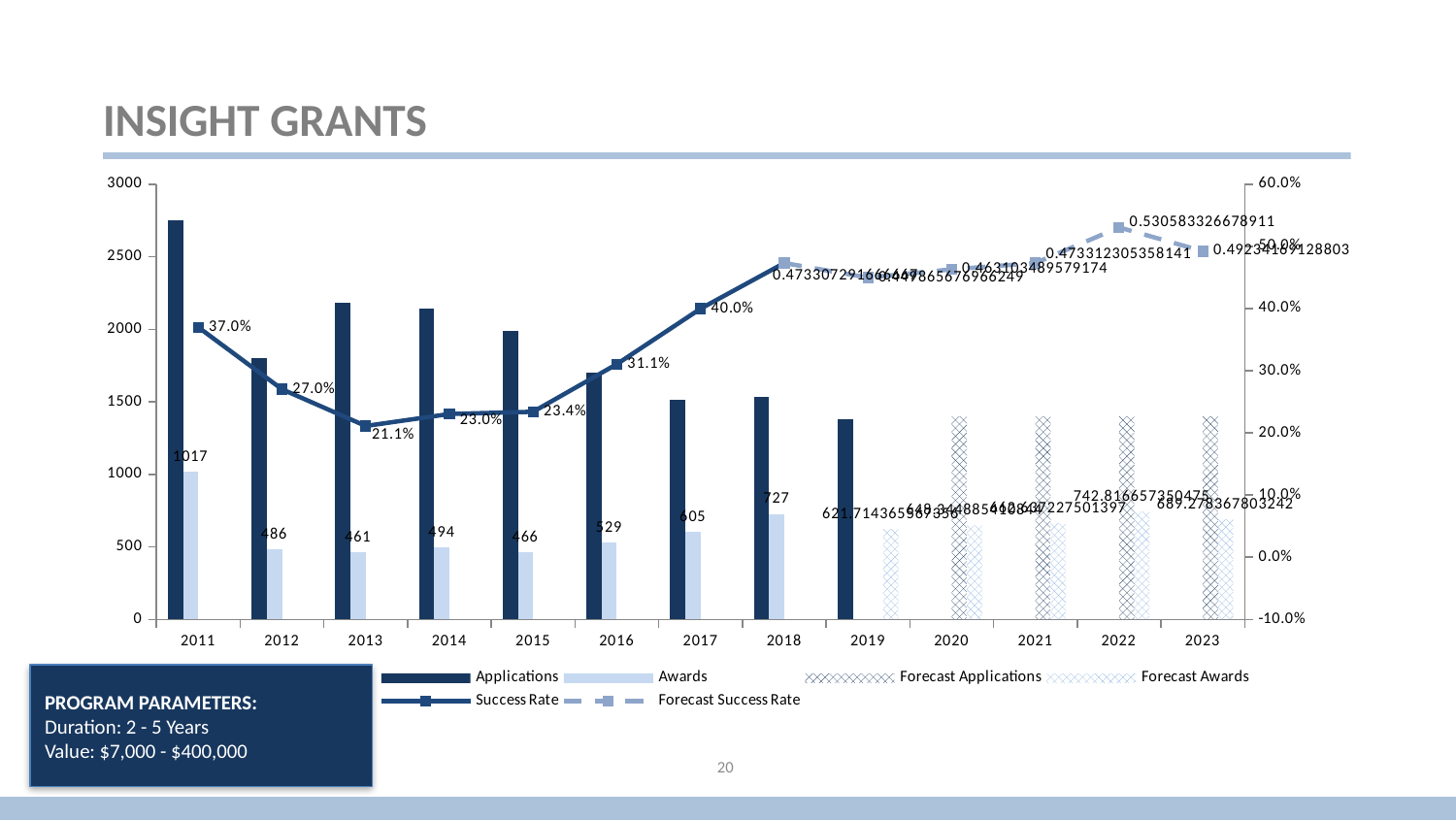
What is the Success Rate for 2013? 21.1% What is the value of Awards for 2011? 1017 Which year has the lowest labelled Success Rate? 2013 Is the value for Applications in 2011 greater or less than 2500? greater What is the Success Rate for 2017? 40.0% Does the Success Rate rise or fall from 2013 to 2017? rise Which is larger, Awards in 2014 or Awards in 2013? 2014 Is the value for Applications in 2019 greater or less than 1500? less Which year has the highest Awards value? 2011 What is the difference between Awards in 2018 and Awards in 2017? 122 How many series does the legend list? 6 What is the value of Awards for 2018? 727